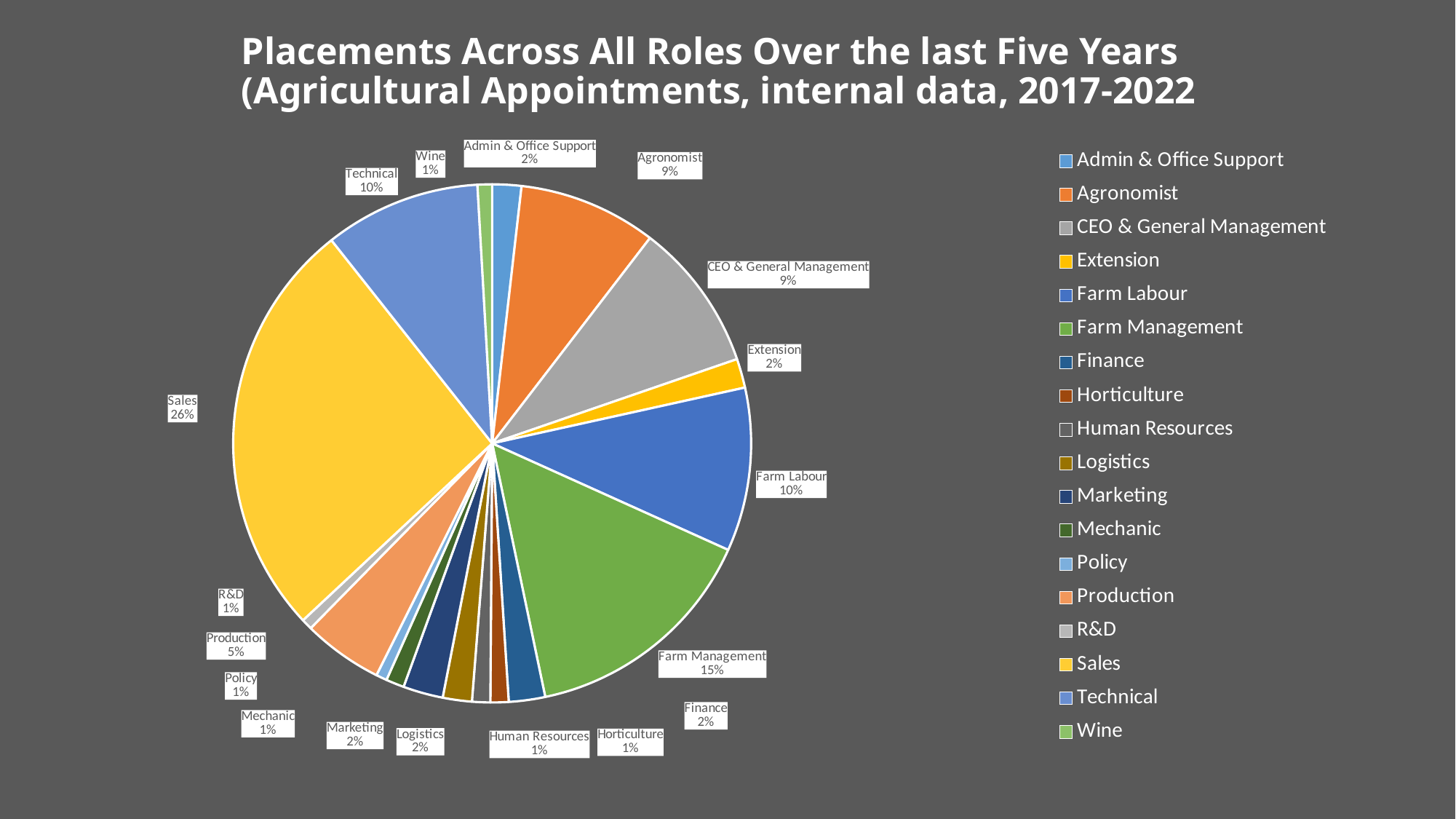
Which is larger, the share for Farm Labour or the share for Agronomist? Farm Labour What type of chart is shown on the slide? Pie chart How many entries does the legend list? 18 How many categories (slices) does the pie chart have? 18 What is the difference in percentage points between Sales and Farm Management? 11 Which role has the largest share of placements? Sales What share of placements does Sales account for? 26% What is the title of the chart? Placements Across All Roles Over the last Five Years (Agricultural Appointments, internal data, 2017-2022 What is the value shown for Farm Management? 15% What is the value shown for Technical? 10% What is the combined share of Agronomist and CEO & General Management? 18% What percentage is shown for Production? 5%